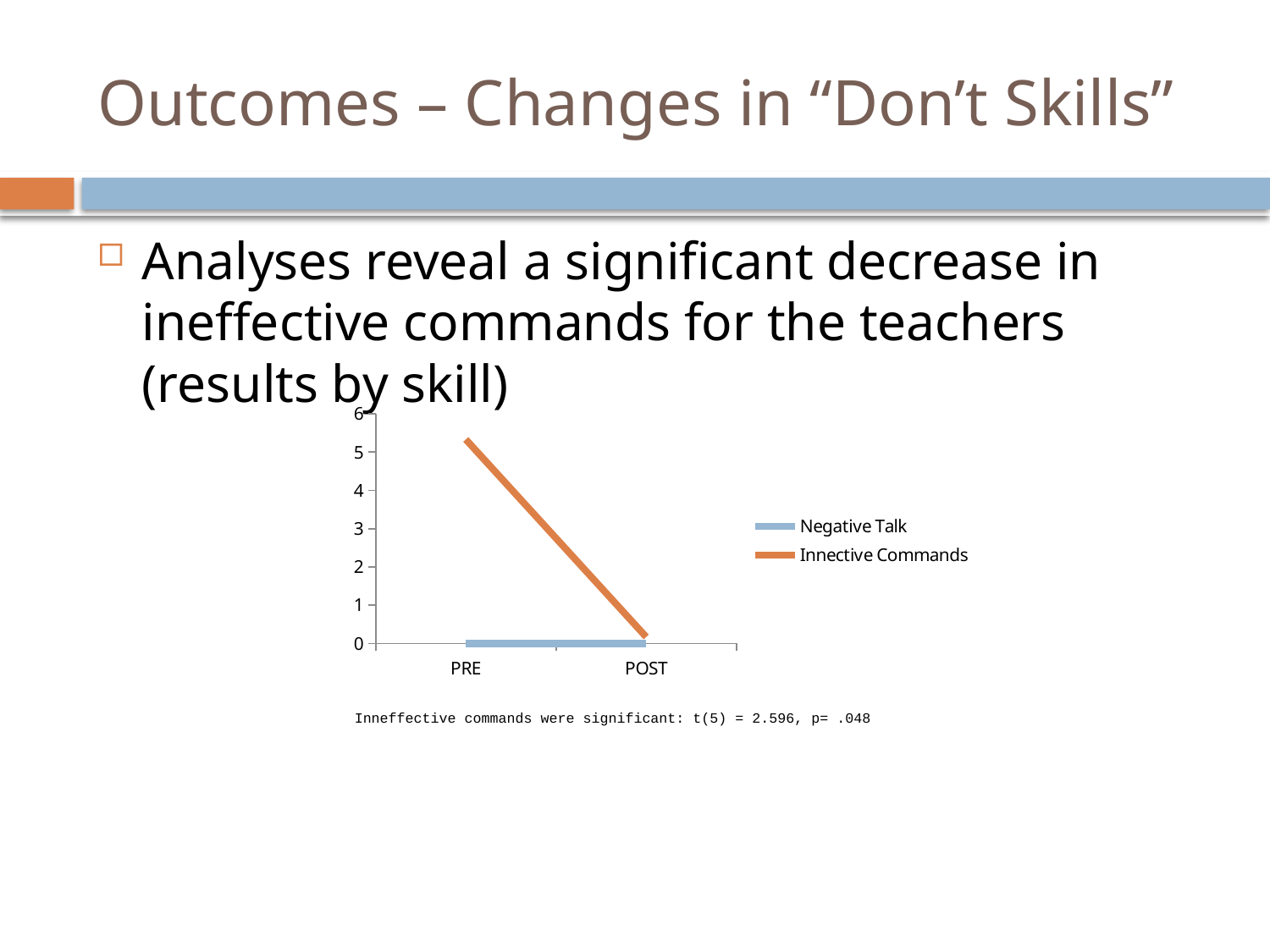
At which category does the Innective Commands series reach its highest value? PRE How many categories are shown on the x axis of the chart? 2 At PRE, which series has the higher value: Negative Talk or Innective Commands? Innective Commands For Innective Commands, which is larger: the PRE value or the POST value? PRE Is the value for Negative Talk at PRE greater or less than 1? less What kind of chart is shown on the slide? line chart Is the value for Innective Commands at PRE greater or less than 4? greater What are the two categories on the x axis of the chart? PRE and POST How many series does the chart's legend list? 2 Does the Innective Commands series rise or fall from PRE to POST? fall Is the value for Innective Commands at POST greater or less than 1? less Which series is drawn in orange in the chart? Innective Commands